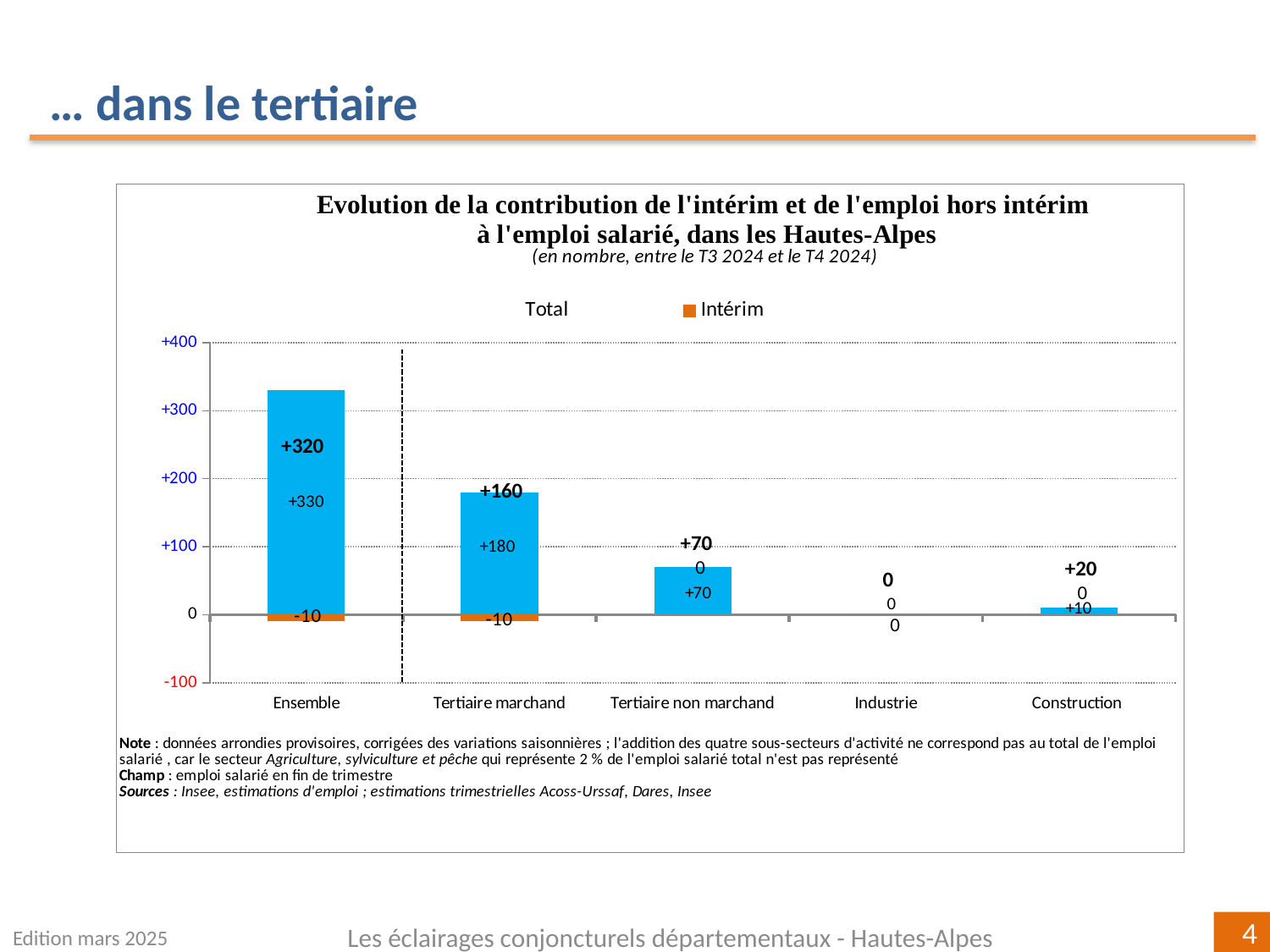
Which has a larger total value, Tertiaire non marchand or Construction? Tertiaire non marchand What is the difference between the total values for Ensemble and Tertiaire marchand? 160 Which category has the lowest total value? Industrie Which category has the highest total value? Ensemble How many series does the legend list? 2 What kind of chart is shown on the slide? Bar chart What is the Intérim value shown for Ensemble? -10 What is the total value shown for Construction? +20 What is the total value shown for Tertiaire non marchand? +70 What is the total value shown for Ensemble? +320 What is the total value shown for Tertiaire marchand? +160 How many categories are shown on the x axis? 5